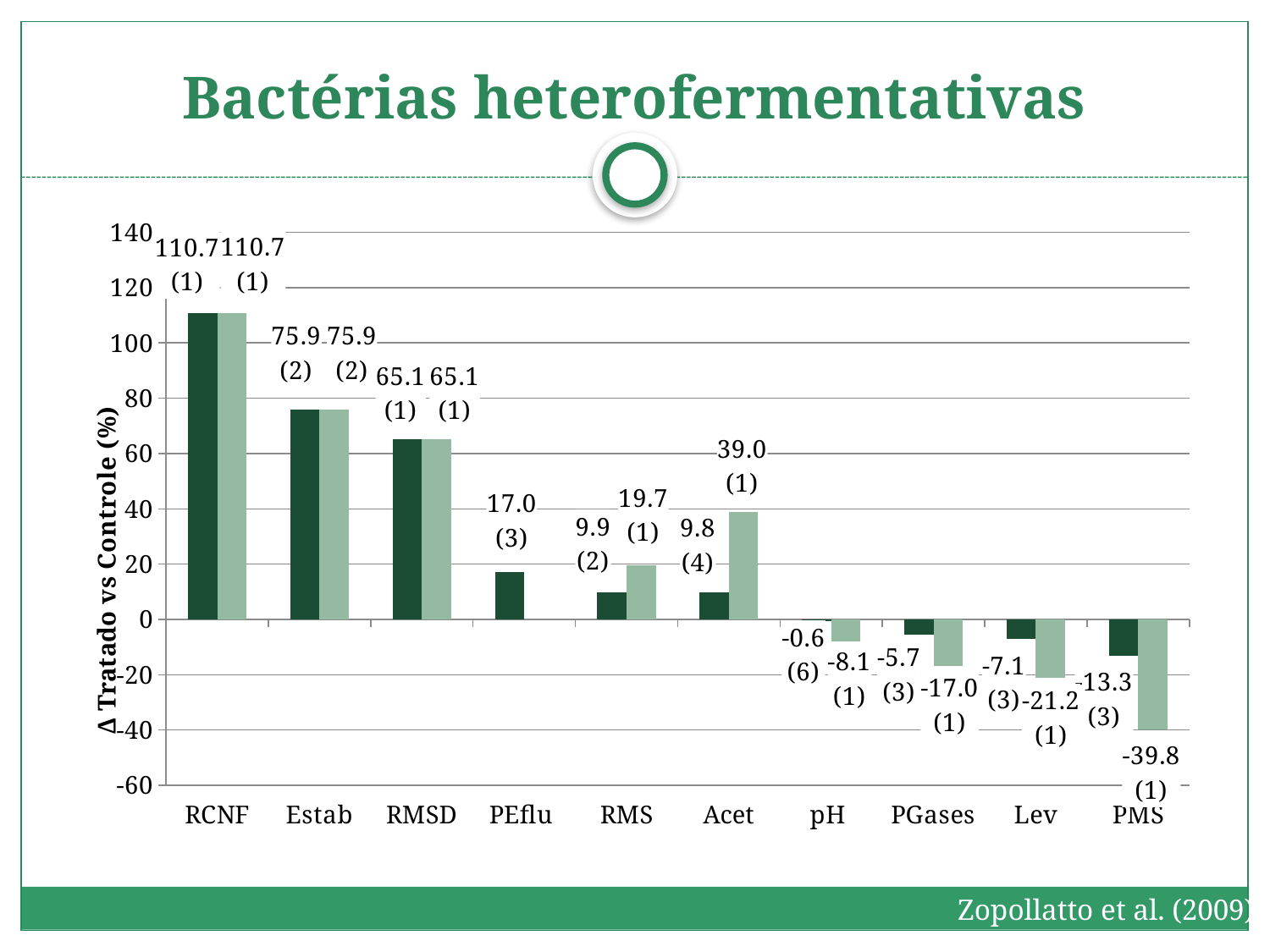
What is the value of the light green bar for PMS? -39.8 What is the value of the dark green bar for PEflu? 17.0 What is the value of the light green bar for Acet? 39.0 Which category has the lowest value in the chart? PMS Which is larger for RMS: the dark green bar or the light green bar? the light green bar How many categories are shown on the x axis of the chart? 10 Which category has the highest value in the chart? RCNF What is the difference between the dark green bar for Estab and the dark green bar for RMSD? 10.8 What type of chart is shown on the slide? bar chart What is the value of the dark green bar for RCNF? 110.7 What is the y-axis title of the chart? Δ Tratado vs Controle (%) What is the difference between the light green bar and the dark green bar for Acet? 29.2